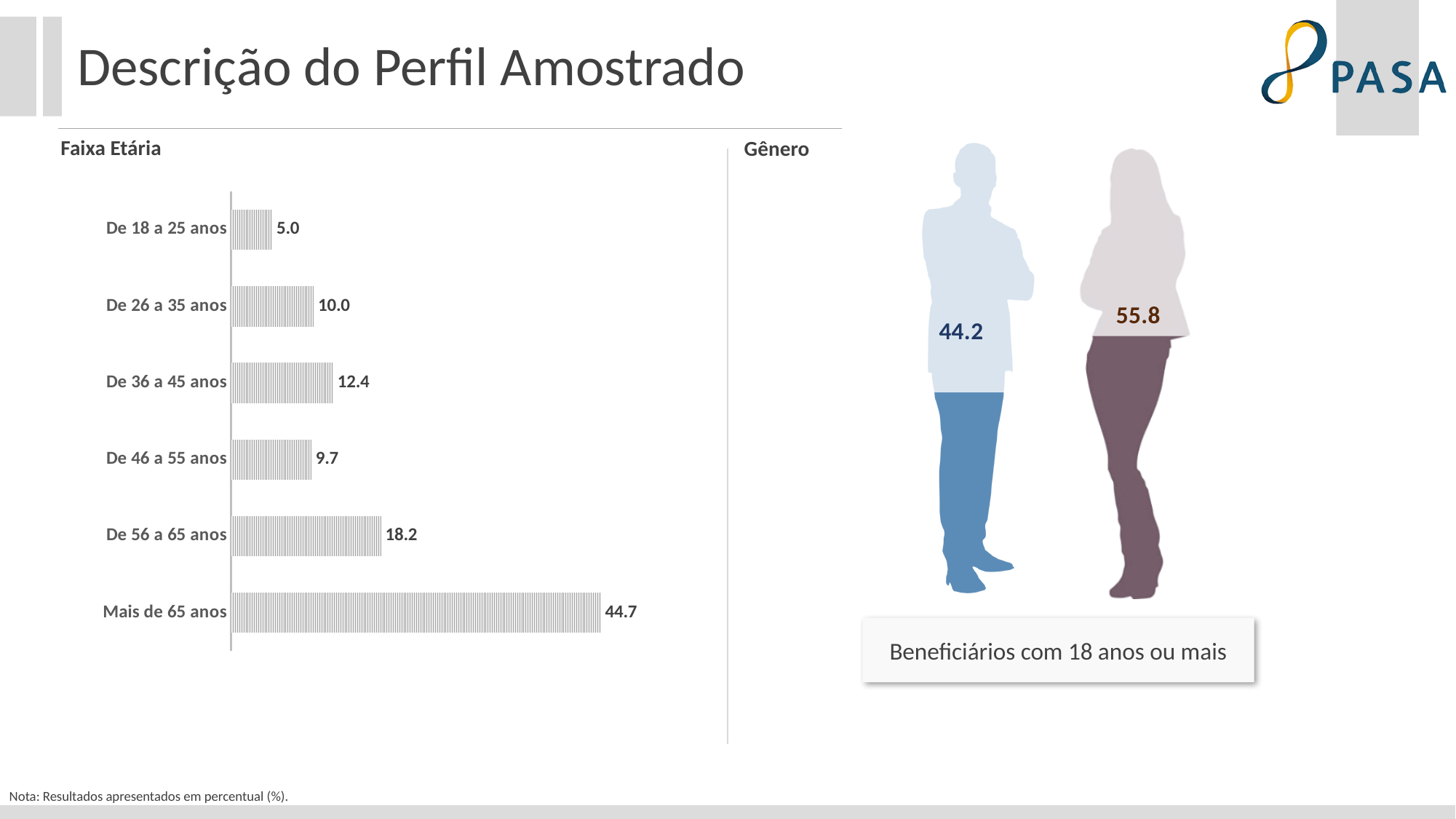
What is the title of the slide? Descrição do Perfil Amostrado In the Gênero section, what is the difference between the female and male values? 11.6 In the Gênero section, what is the value shown for the female figure? 55.8 In the Faixa Etária chart, which age group has the highest value? Mais de 65 anos In the Faixa Etária chart, what is the value for De 36 a 45 anos? 12.4 In the Faixa Etária chart, what is the value for De 18 a 25 anos? 5.0 In the Faixa Etária chart, which is larger: De 26 a 35 anos or De 46 a 55 anos? De 26 a 35 anos What kind of chart is the Faixa Etária chart? Bar chart In the Faixa Etária chart, what is the difference between Mais de 65 anos and De 56 a 65 anos? 26.5 In the Faixa Etária chart, what is the value for De 56 a 65 anos? 18.2 In the Faixa Etária chart, which age group has the lowest value? De 18 a 25 anos How many age groups are shown in the Faixa Etária chart? 6